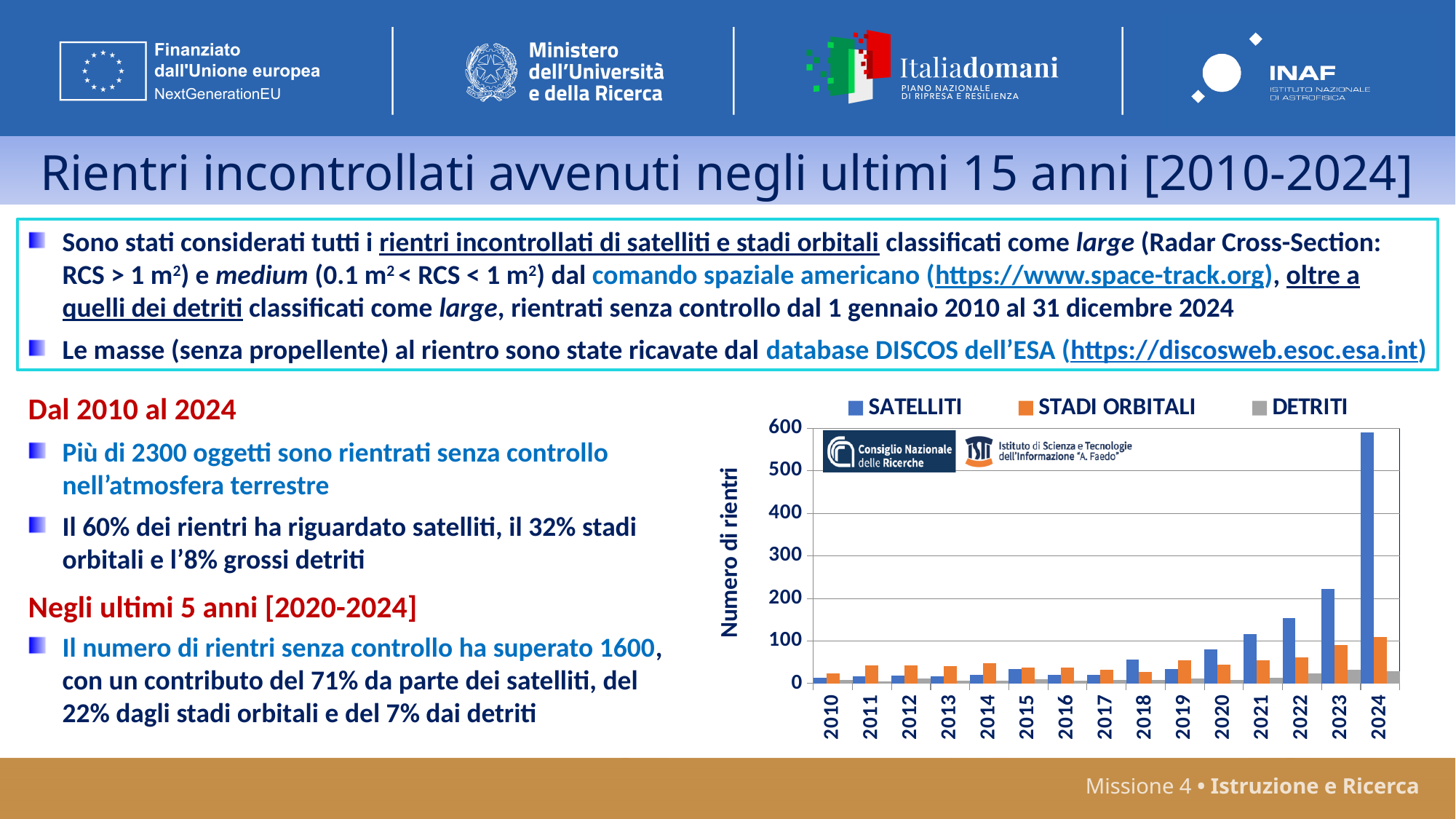
How many years are shown along the x axis of the chart? 15 What kind of chart is shown on the slide? bar chart Do the SATELLITI values generally rise or fall from 2010 to 2024? rise In 2010, which is larger: the SATELLITI bar or the STADI ORBITALI bar? STADI ORBITALI Is the SATELLITI value for 2023 greater or less than 200? greater Is the SATELLITI value for 2022 greater or less than 100? greater In which year is the SATELLITI bar the highest? 2024 Is the SATELLITI value for 2024 greater or less than 500? greater How many series does the chart legend list? 3 In 2024, which is larger: the SATELLITI bar or the STADI ORBITALI bar? SATELLITI What is the label of the chart's vertical axis? Numero di rientri